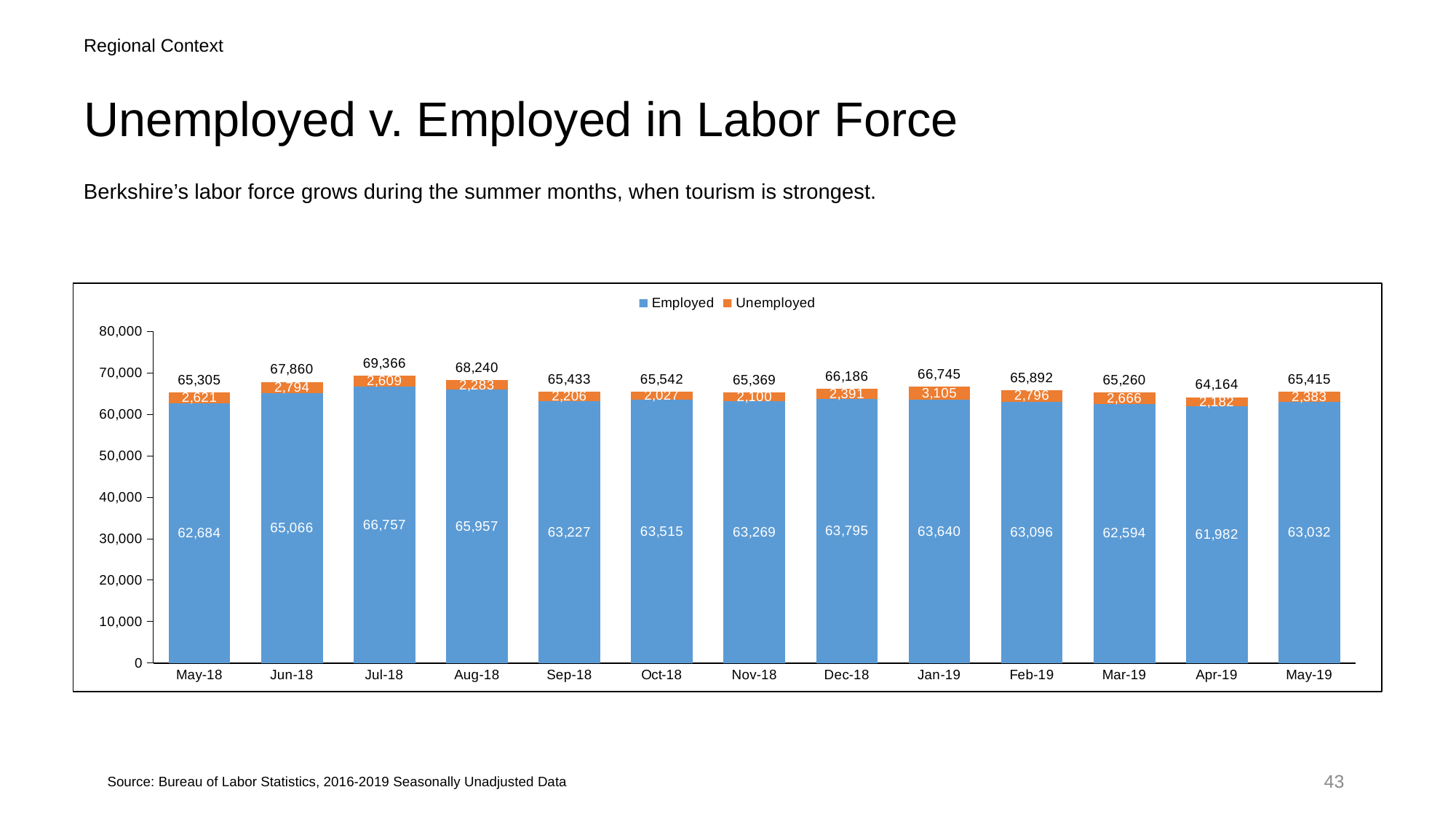
Which month has the highest total labor force? Jul-18 What kind of chart is shown on the slide? Stacked bar chart What is the difference between the Employed value in Jul-18 and in Apr-19? 4,775 Is the total for Jul-18 greater or less than 70,000? less Which month has the lowest Employed value? Apr-19 How many months are shown on the x axis? 13 What is the Employed value for Jul-18? 66,757 How many series does the legend list? 2 What is the Unemployed value for Jan-19? 3,105 Which is larger, the Employed value for Jun-18 or for Dec-18? Jun-18 Which month has the lowest Unemployed value? Oct-18 What is the total of the stacked bar for Aug-18? 68,240